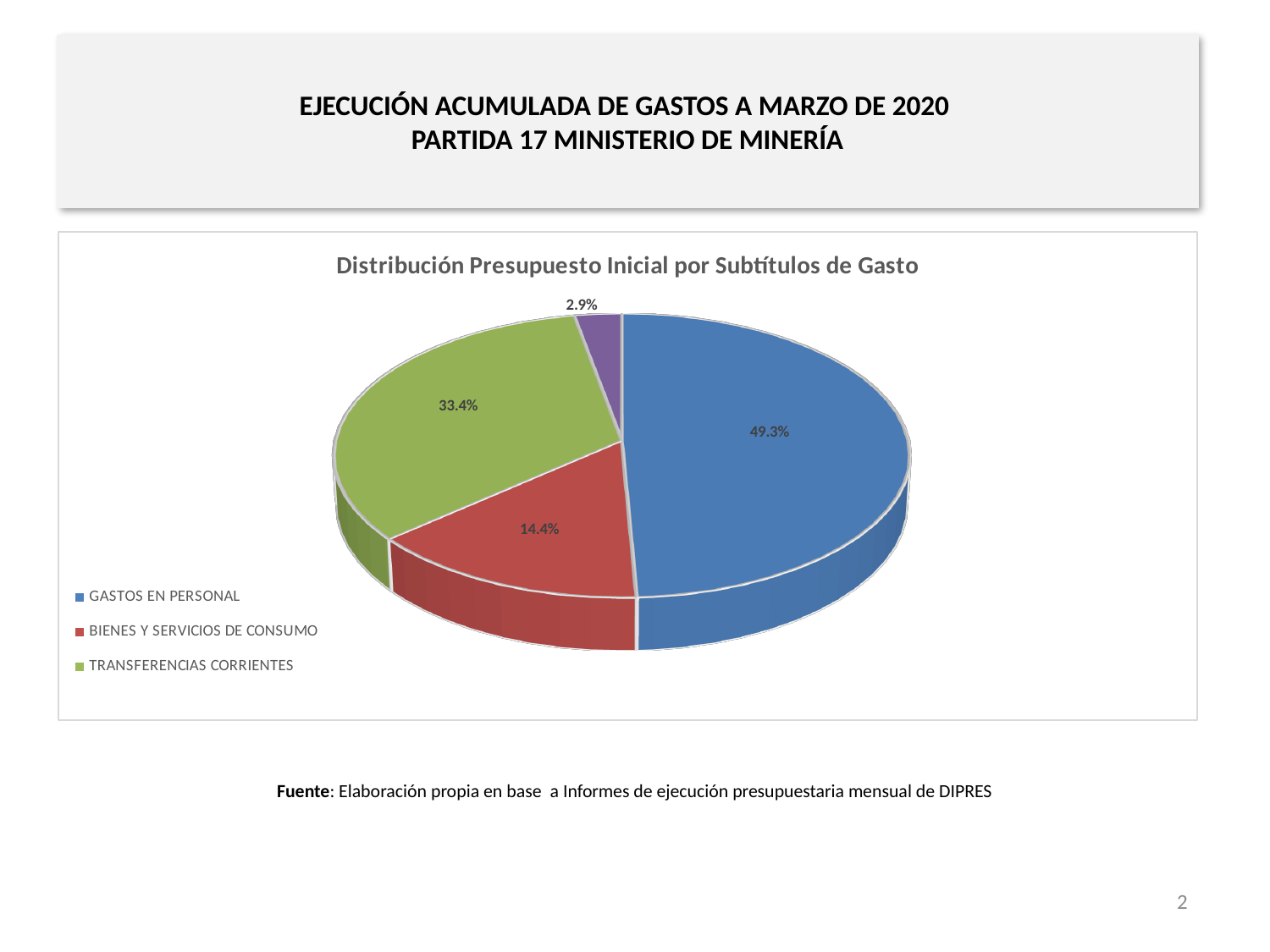
What percentage is shown for TRANSFERENCIAS CORRIENTES? 33.4% What percentage is shown for BIENES Y SERVICIOS DE CONSUMO? 14.4% What colour is the slice for GASTOS EN PERSONAL? blue What is the title of the chart? Distribución Presupuesto Inicial por Subtítulos de Gasto What is the difference in percentage points between TRANSFERENCIAS CORRIENTES and BIENES Y SERVICIOS DE CONSUMO? 19.0 How many entries does the legend list? 3 Which is larger, the share for TRANSFERENCIAS CORRIENTES or the share for BIENES Y SERVICIOS DE CONSUMO? TRANSFERENCIAS CORRIENTES What is the difference in percentage points between GASTOS EN PERSONAL and TRANSFERENCIAS CORRIENTES? 15.9 What type of chart is shown on the slide? pie chart How many slices does the pie chart have? 4 What percentage is shown for GASTOS EN PERSONAL? 49.3% Which category has the largest share of the pie? GASTOS EN PERSONAL